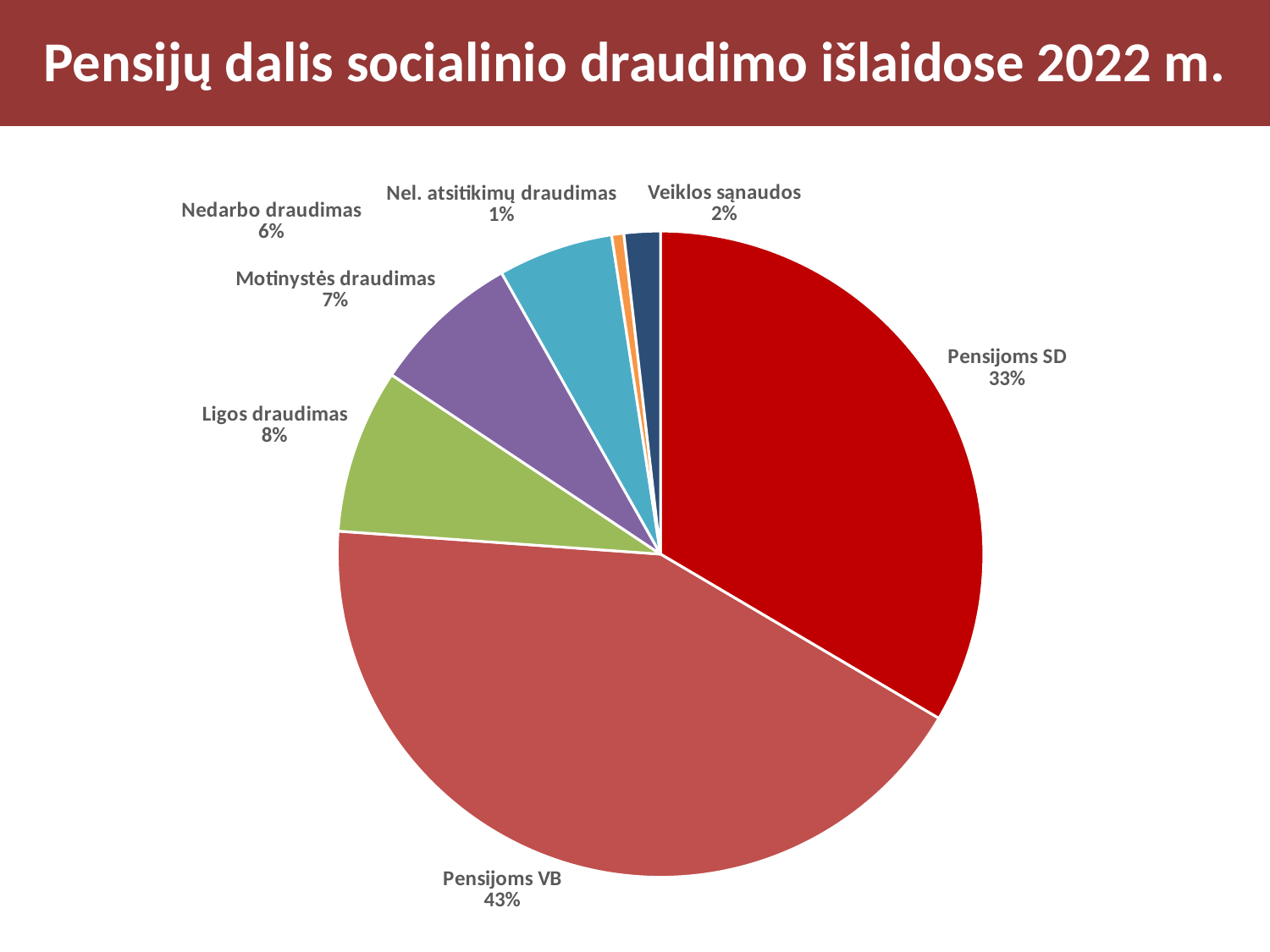
What is the difference between the shares of Pensijoms VB and Pensijoms SD? 10% What is the value for Motinystės draudimas? 7% How many categories are shown in the pie chart? 7 What is the value for Nedarbo draudimas? 6% What is the value for Ligos draudimas? 8% What share of the pie does Pensijoms SD have? 33% Which category has the smallest slice of the pie? Nel. atsitikimų draudimas What share of the pie does Pensijoms VB have? 43% What is the title of the slide? Pensijų dalis socialinio draudimo išlaidose 2022 m. What kind of chart is shown on the slide? pie chart Which is larger, Ligos draudimas or Nedarbo draudimas? Ligos draudimas Which category has the largest slice of the pie? Pensijoms VB